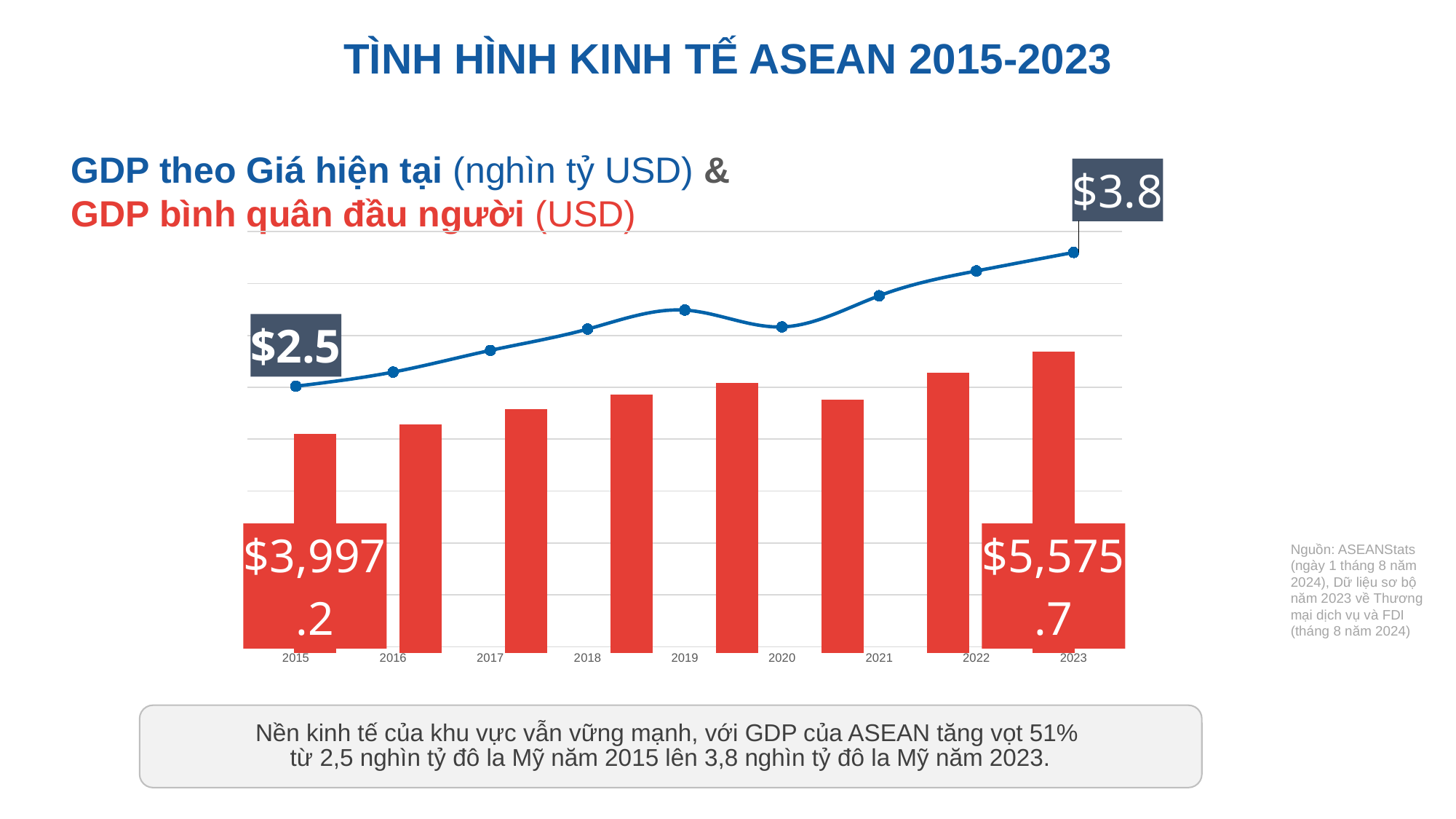
Which year has the tallest GDP per capita bar? 2023 By how much did GDP at current prices (nghìn tỷ USD) increase from 2015 to 2023? $1.3 Is the GDP per capita bar for 2019 taller or shorter than the bar for 2020? Taller Does the GDP line generally rise or fall from 2015 to 2023? Rise How many years are shown on the x axis of the chart? 9 What colour are the GDP per capita bars? Red What is the GDP per capita (USD) shown for 2015? $3,997.2 What is the GDP at current prices (nghìn tỷ USD) shown for 2015? $2.5 What is the GDP at current prices (nghìn tỷ USD) shown for 2023? $3.8 Which year has the shortest GDP per capita bar? 2015 What kind of chart is used on the slide? Combined bar and line chart What is the GDP per capita (USD) shown for 2023? $5,575.7